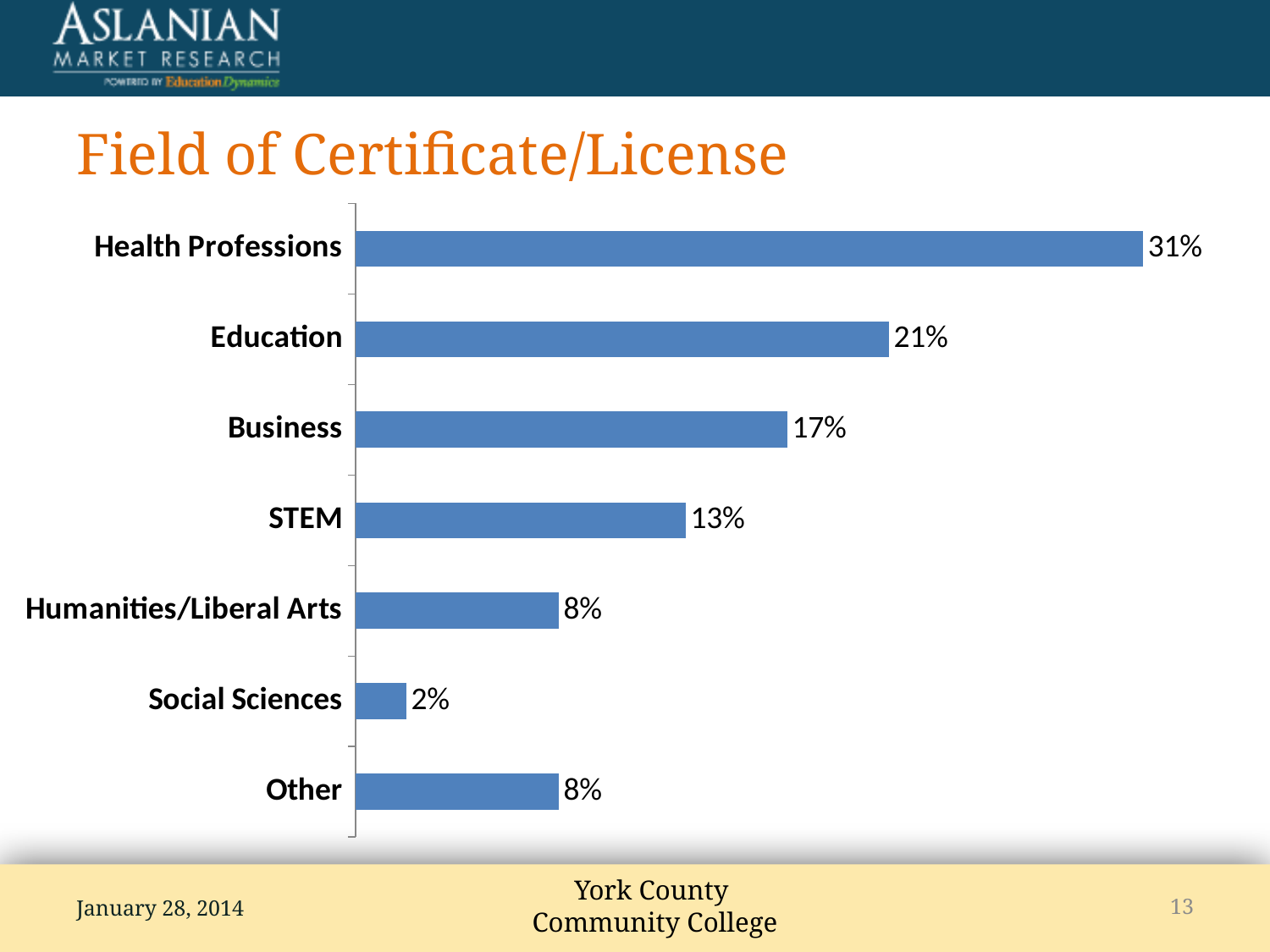
Which field has the highest value? Health Professions Which is larger, the value for Business or the value for Humanities/Liberal Arts? Business What is the value for Education? 21% What is the difference between the values for Health Professions and Education? 10% Which field has the lowest value? Social Sciences What is the value for Health Professions? 31% What is the value for STEM? 13% What is the title of the slide? Field of Certificate/License How many fields are shown in the chart? 7 What is the difference between the values for Business and STEM? 4% What kind of chart is shown on the slide? Bar chart What is the value for Social Sciences? 2%